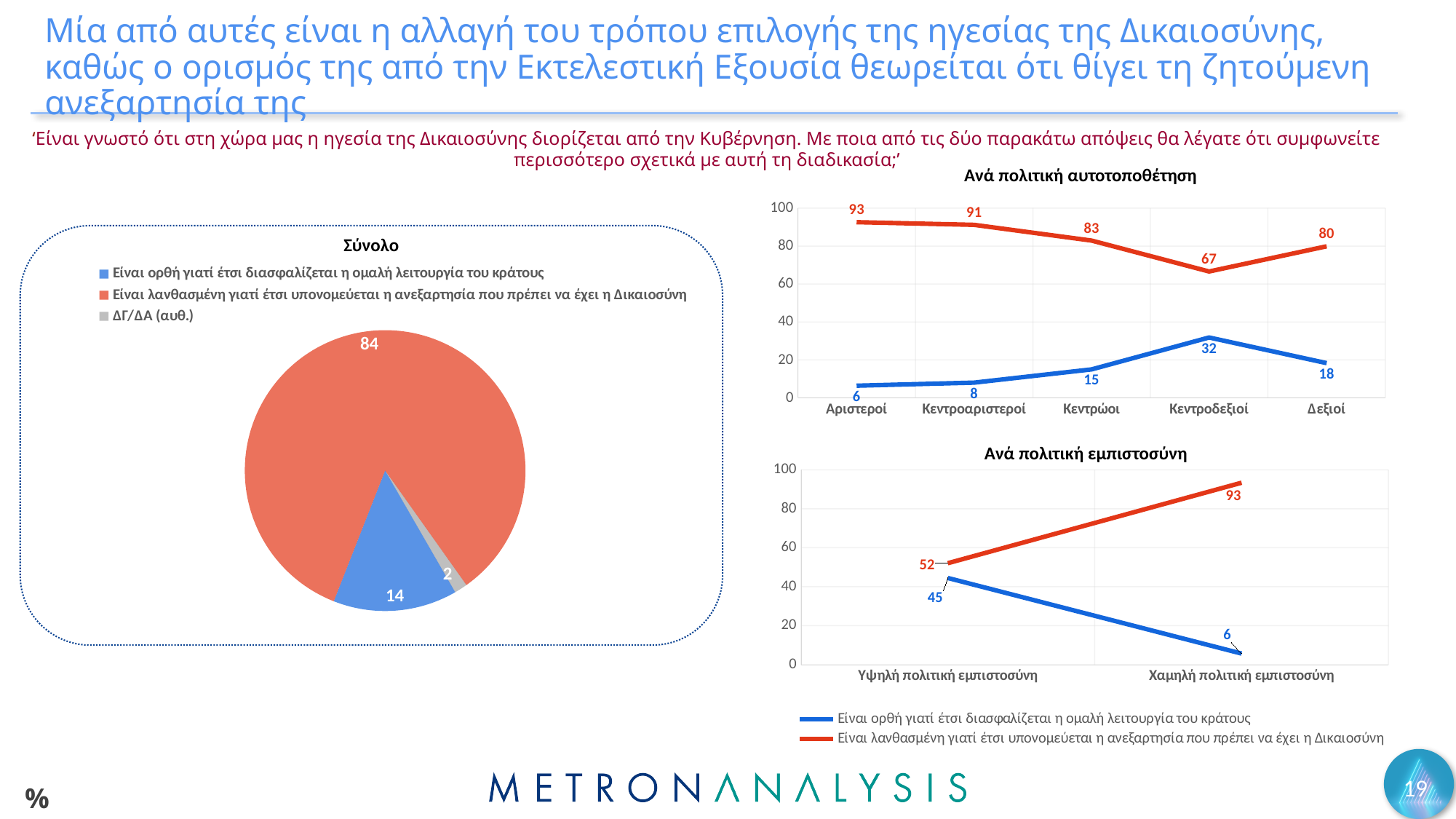
In the 'Σύνολο' pie chart, what is the value for 'Είναι λανθασμένη γιατί έτσι υπονομεύεται η ανεξαρτησία που πρέπει να έχει η Δικαιοσύνη'? 84 In the 'Ανά πολιτική αυτοτοποθέτηση' chart, what is the value of the blue series ('Είναι ορθή...') for 'Κεντρώοι'? 15 What kind of chart is the 'Σύνολο' chart? Pie chart In the 'Ανά πολιτική εμπιστοσύνη' chart, does the red series ('Είναι λανθασμένη...') rise or fall from 'Υψηλή πολιτική εμπιστοσύνη' to 'Χαμηλή πολιτική εμπιστοσύνη'? Rise In the 'Ανά πολιτική αυτοτοποθέτηση' chart, what is the value of the red series ('Είναι λανθασμένη...') for 'Κεντροδεξιοί'? 67 In the 'Ανά πολιτική αυτοτοποθέτηση' chart, how many categories are shown on the x axis? 5 In the 'Σύνολο' pie chart, how many slices are there? 3 In the 'Ανά πολιτική αυτοτοποθέτηση' chart, what is the difference between the red series values for 'Αριστεροί' and 'Δεξιοί'? 13 How many series does the legend below the 'Ανά πολιτική εμπιστοσύνη' chart list? 2 In the 'Ανά πολιτική εμπιστοσύνη' chart, what is the value of the blue series ('Είναι ορθή...') for 'Χαμηλή πολιτική εμπιστοσύνη'? 6 In the 'Ανά πολιτική αυτοτοποθέτηση' chart, which category has the highest value for the blue series ('Είναι ορθή...')? Κεντροδεξιοί In the 'Σύνολο' pie chart, what is the value for 'ΔΓ/ΔΑ (αυθ.)'? 2